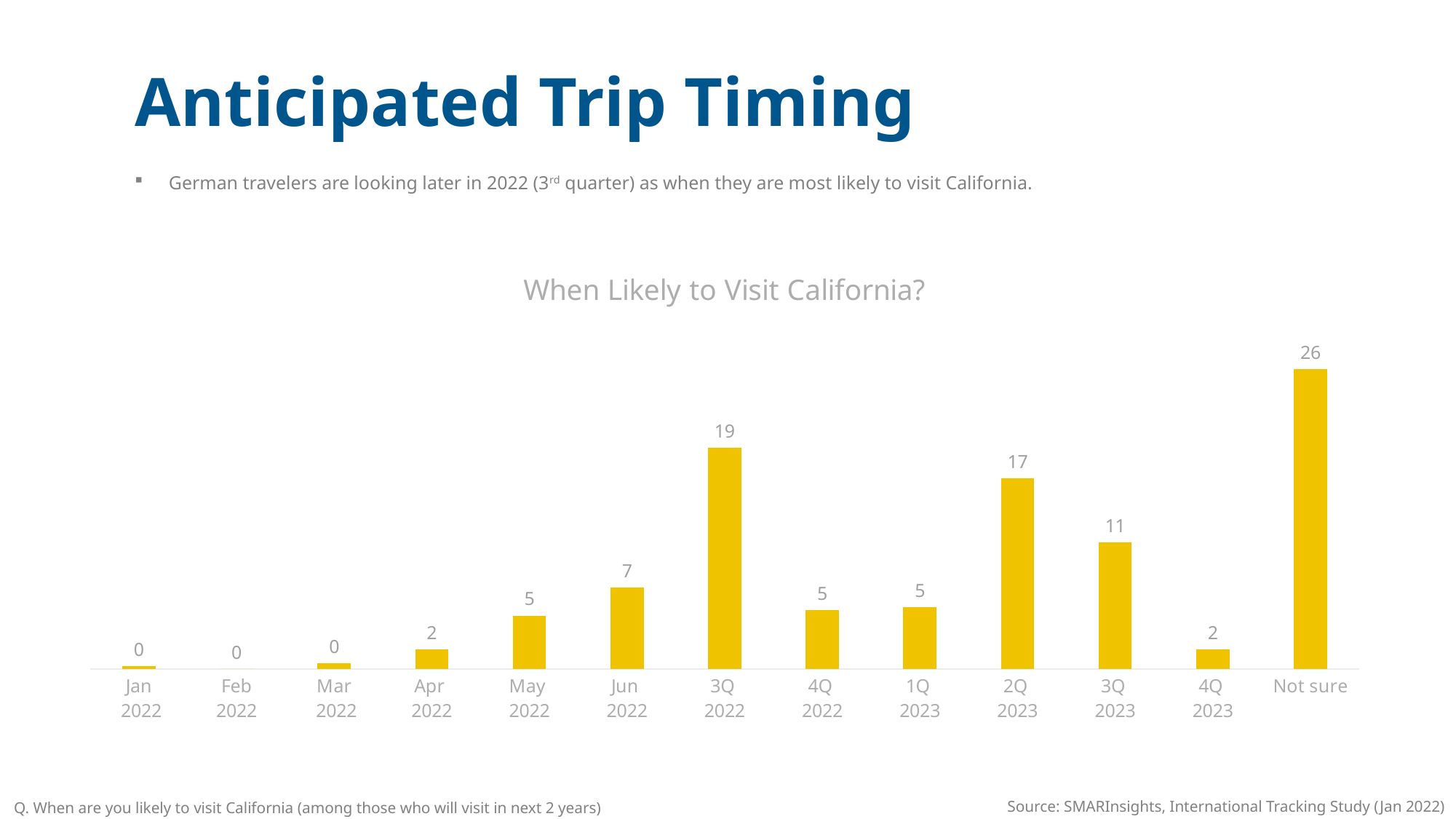
Which category has the highest value among the dated periods (excluding Not sure)? 3Q 2022 What is the difference between the values for 2Q 2023 and 3Q 2023? 6 What kind of chart is this? Bar chart Which is larger, the value for 3Q 2022 or the value for 2Q 2023? 3Q 2022 How many categories are shown on the x axis? 13 What is the value for Jun 2022? 7 Which category has the highest value? Not sure What is the value for Not sure? 26 What is the value for 2Q 2023? 17 What is the title of the chart? When Likely to Visit California? What is the value for 3Q 2022? 19 What is the difference between the values for Not sure and 3Q 2022? 7